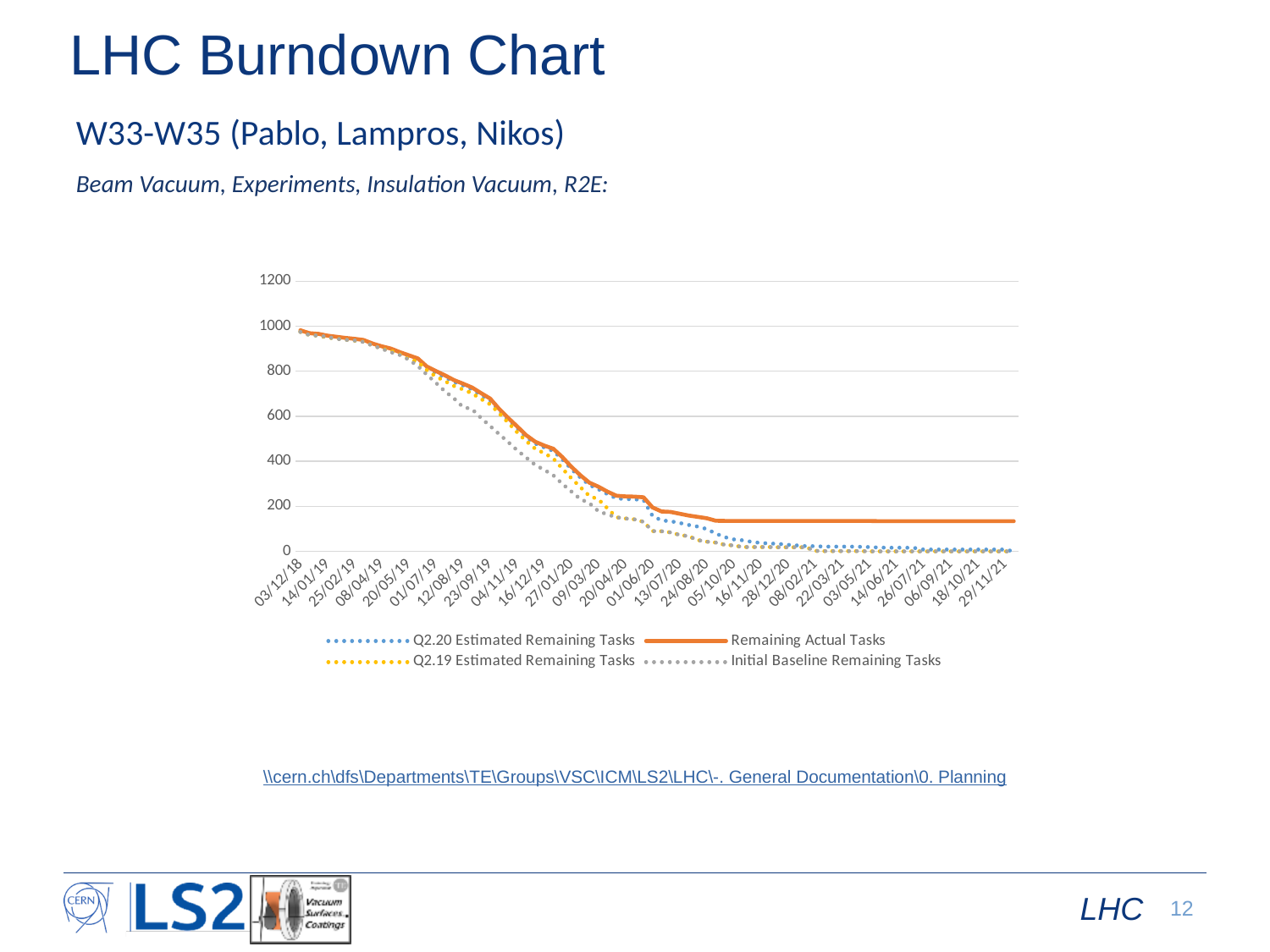
Is the value of Remaining Actual Tasks at 03/12/18 greater or less than 800? greater At 29/11/21, which is larger: Remaining Actual Tasks or Initial Baseline Remaining Tasks? Remaining Actual Tasks Is the value of Remaining Actual Tasks at 29/11/21 greater or less than 200? less What kind of chart is shown on the slide? line chart Is the value of Remaining Actual Tasks at 09/03/20 greater or less than 200? greater Which series has the highest value at the last date, 29/11/21? Remaining Actual Tasks Which series in the legend is drawn as a solid line rather than a dotted line? Remaining Actual Tasks How many series does the chart legend list? 4 What is the highest tick value shown on the y axis? 1200 Do the values of the Remaining Actual Tasks series rise or fall along the x axis? fall